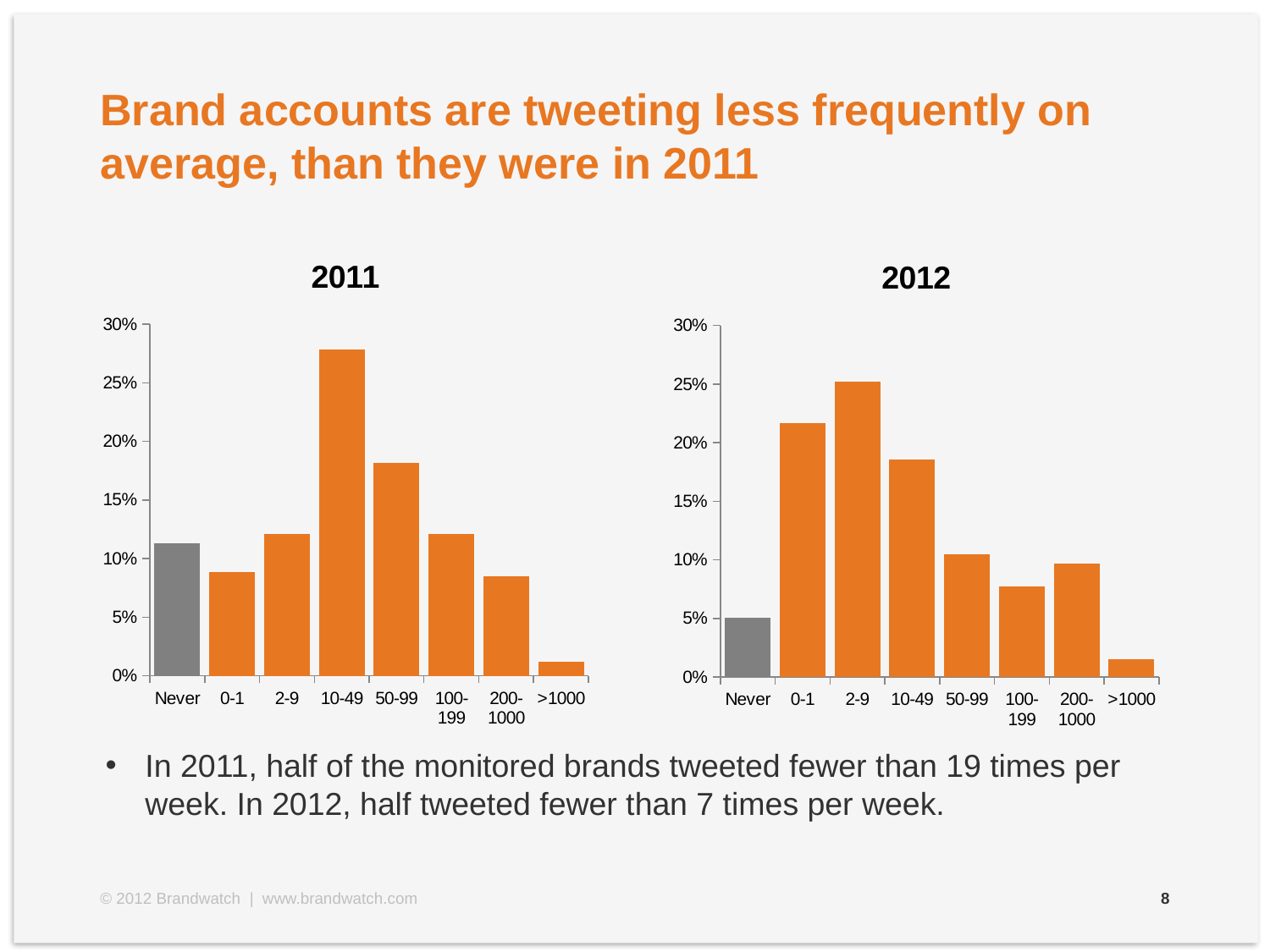
In the 2012 chart, is the value for Never greater or less than 10%? less In the 2012 chart, which is larger, the value for 10-49 or the value for 50-99? 10-49 In the 2012 chart, is the value for 0-1 greater or less than 20%? greater What kind of chart is the 2011 chart? bar chart In the 2011 chart, which category has the highest bar? 10-49 In the 2012 chart, which category has the highest bar? 2-9 In the 2011 chart, is the value for 10-49 greater or less than 25%? greater How many categories are shown on the x axis of the 2012 chart? 8 In the 2011 chart, which category's bar is coloured grey rather than orange? Never In the 2011 chart, which is larger, the value for 50-99 or the value for 100-199? 50-99 In the 2011 chart, which category has the lowest bar? >1000 In the 2012 chart, which category has the lowest bar? >1000